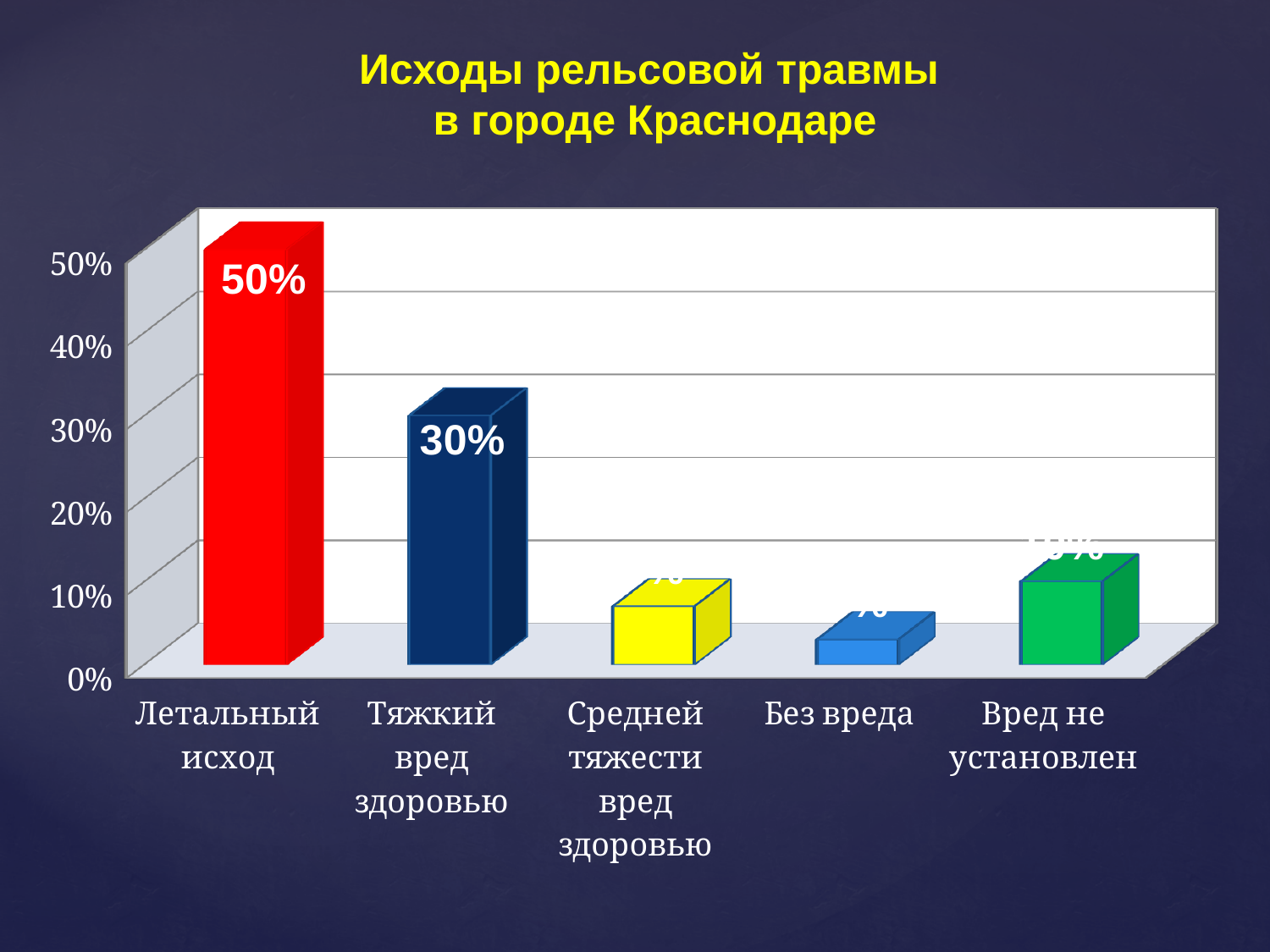
How many categories are shown on the chart? 5 Is the value for Тяжкий вред здоровью greater or less than 20%? greater What colour is the bar for Летальный исход? red Which is larger, the value for Летальный исход or the value for Тяжкий вред здоровью? Летальный исход Is the value for Без вреда greater or less than 10%? less What is the difference between the values for Летальный исход and Тяжкий вред здоровью? 20% Which category has the highest value? Летальный исход What is the value for Летальный исход? 50% Which category has the lowest value? Без вреда What kind of chart is shown on the slide? bar chart What is the value for Тяжкий вред здоровью? 30% What is the title of the slide? Исходы рельсовой травмы в городе Краснодаре